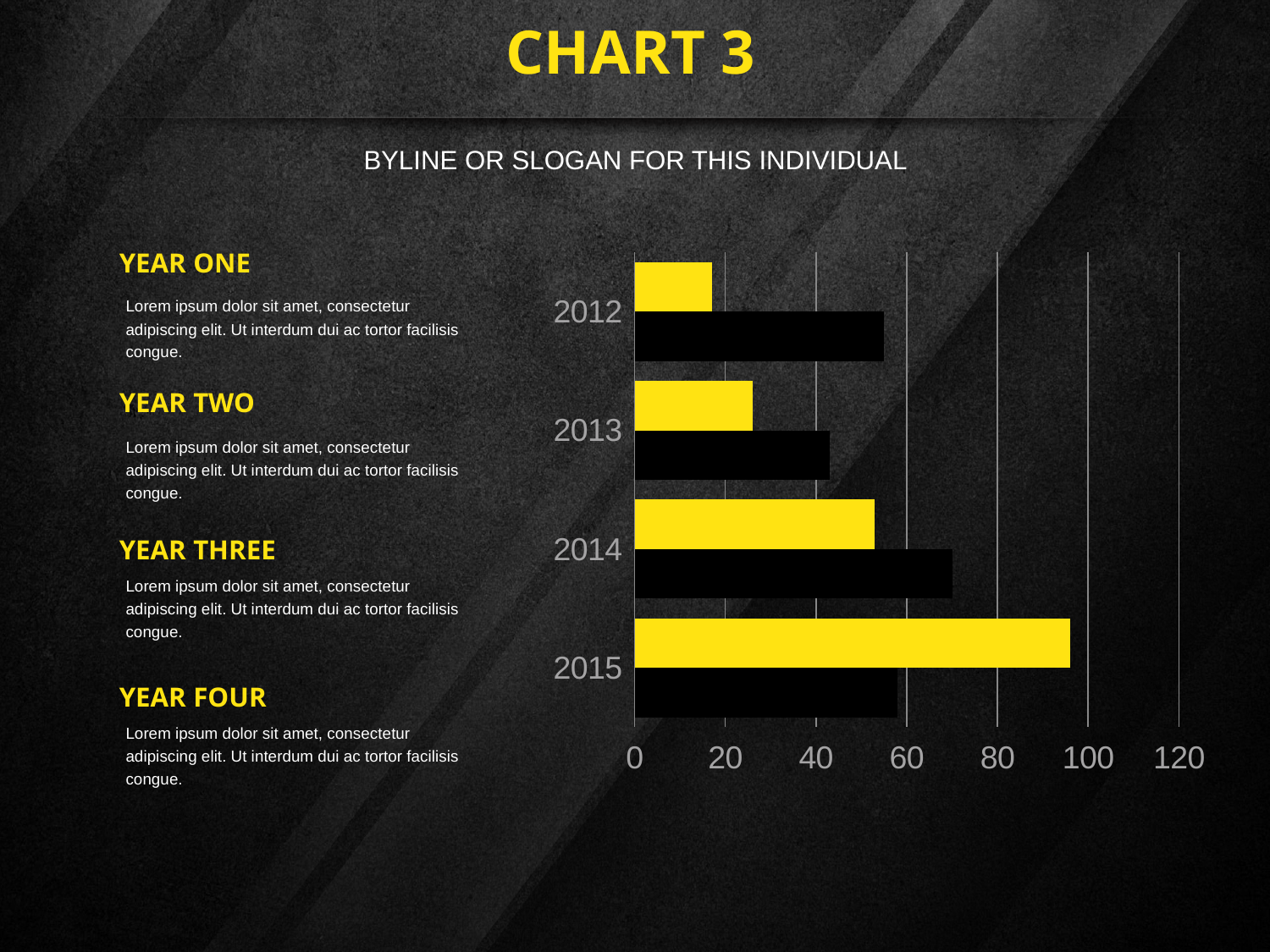
Which year has the longest yellow bar? 2015 How many categories (years) are shown on the chart? 4 For 2013, which bar is longer, the yellow bar or the black bar? the black bar Which year has the shortest yellow bar? 2012 Is the black bar for 2014 greater or less than 60? greater Do the yellow bars rise or fall from 2012 to 2015? rise Is the yellow bar for 2012 greater or less than 20? less What is the highest value shown on the horizontal axis? 120 Which year has the longest black bar? 2014 Which year has the shortest black bar? 2013 Is the yellow bar for 2015 greater or less than 80? greater What kind of chart is shown on the slide? bar chart